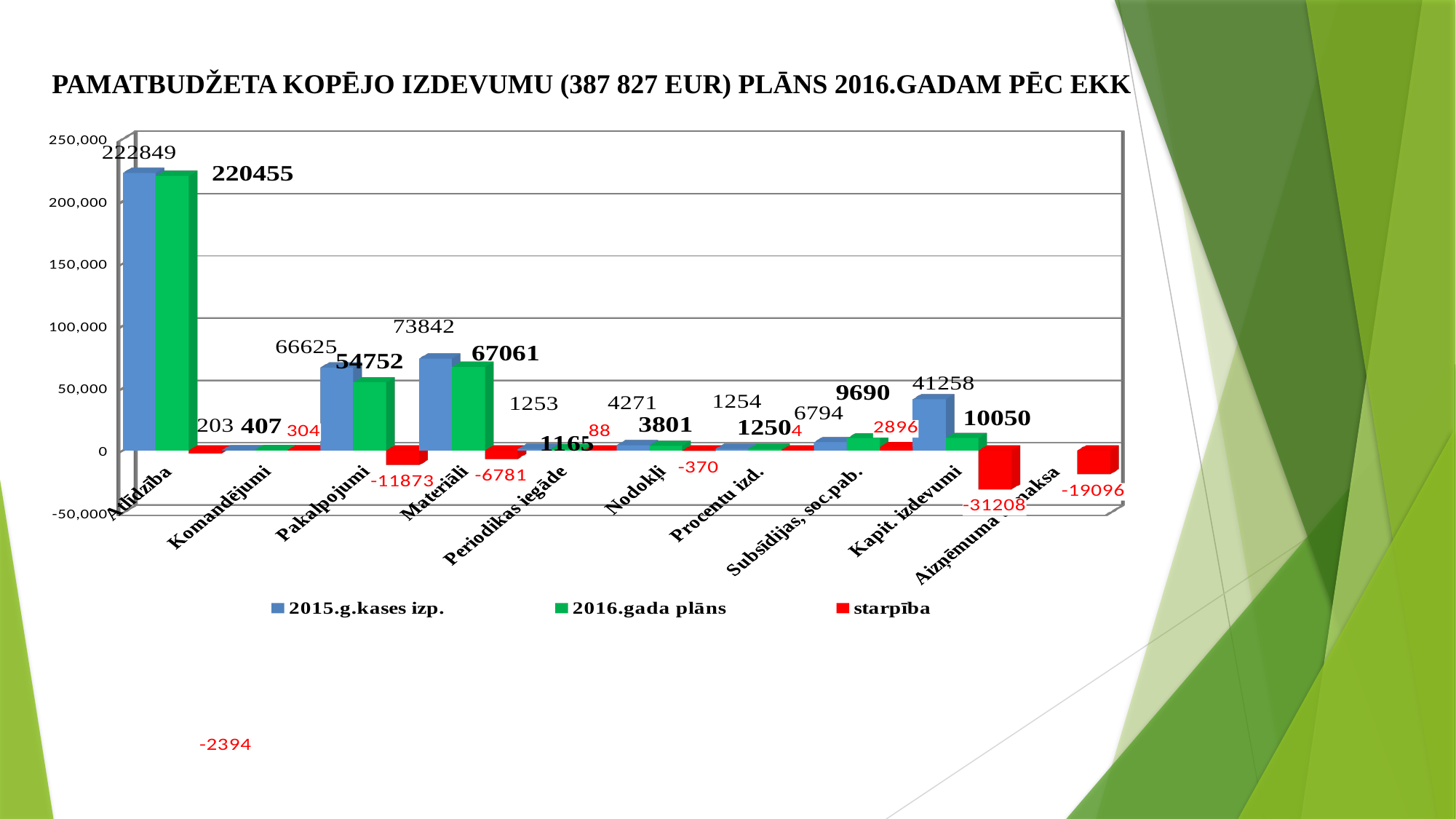
Which category has the highest 2015.g.kases izp. value? Atlīdzība What is the 2016.gada plāns value for Atlīdzība? 220455 What kind of chart is shown on the slide? bar chart What is the starpība value for Kapit. izdevumi? -31208 What is the starpība value for Pakalpojumi? -11873 Is the 2015.g.kases izp. value for Atlīdzība greater or less than 200,000? greater What is the difference between the 2016.gada plāns and 2015.g.kases izp. values for Subsīdijas, soc.pab.? 2896 How many series does the legend list? 3 What is the 2015.g.kases izp. value for Materiāli? 73842 For Pakalpojumi, which is larger: the 2015.g.kases izp. value or the 2016.gada plāns value? 2015.g.kases izp. What is the 2016.gada plāns value for Kapit. izdevumi? 10050 Which series is shown in red in the legend? starpība